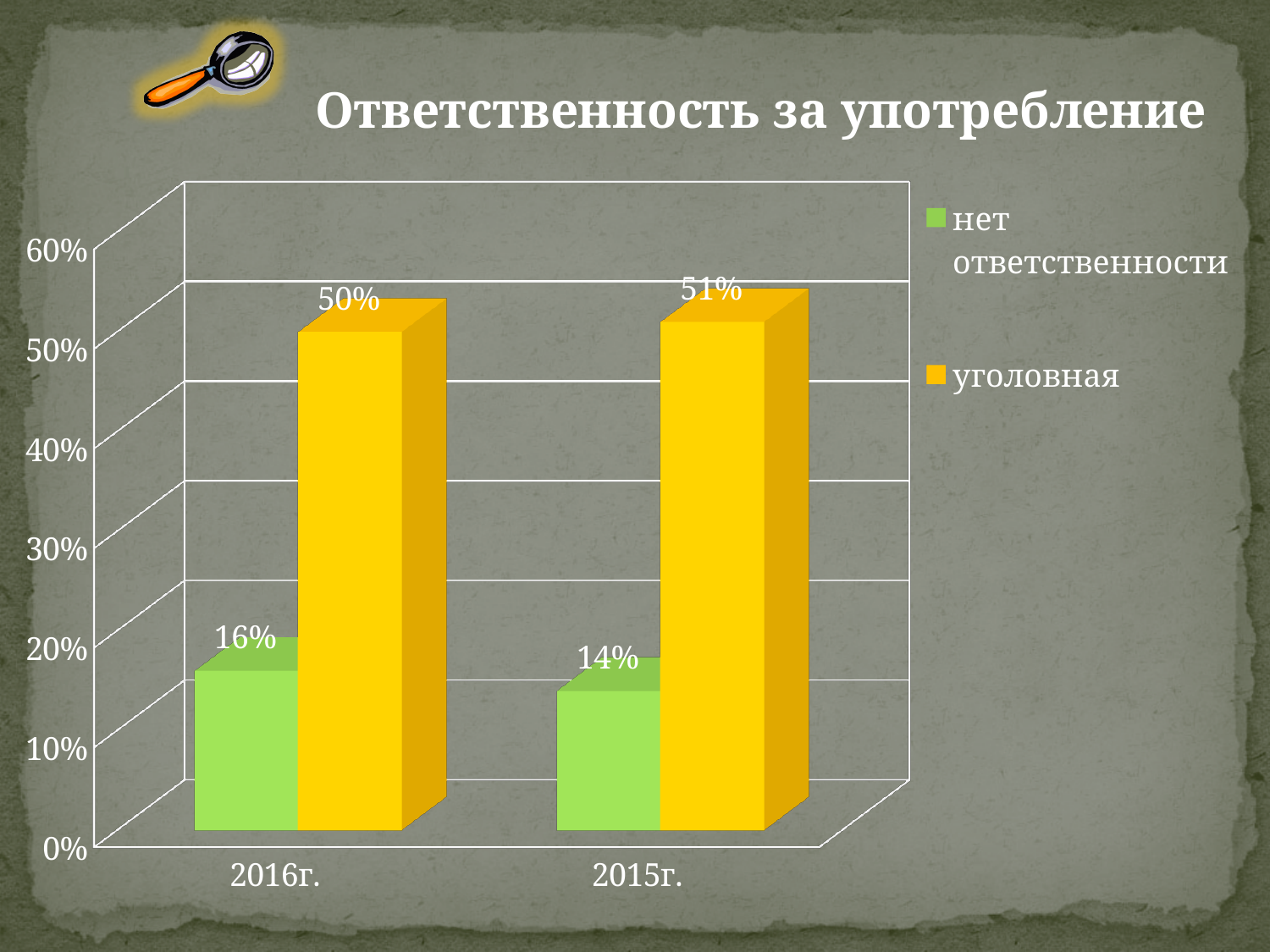
What is the value for 'нет ответственности' in 2015г.? 14% What is the title of the slide? Ответственность за употребление Is the value for 'уголовная' in 2015г. greater or less than 40%? greater What kind of chart is shown on the slide? bar chart What is the value for 'уголовная' in 2016г.? 50% What is the difference between the 'уголовная' value and the 'нет ответственности' value in 2016г.? 34% How many categories are shown on the x axis? 2 What is the value for 'уголовная' in 2015г.? 51% What is the value for 'нет ответственности' in 2016г.? 16% Which year has the higher value for 'нет ответственности'? 2016г. How many series does the legend list? 2 What is the difference between the 'нет ответственности' values for 2016г. and 2015г.? 2%